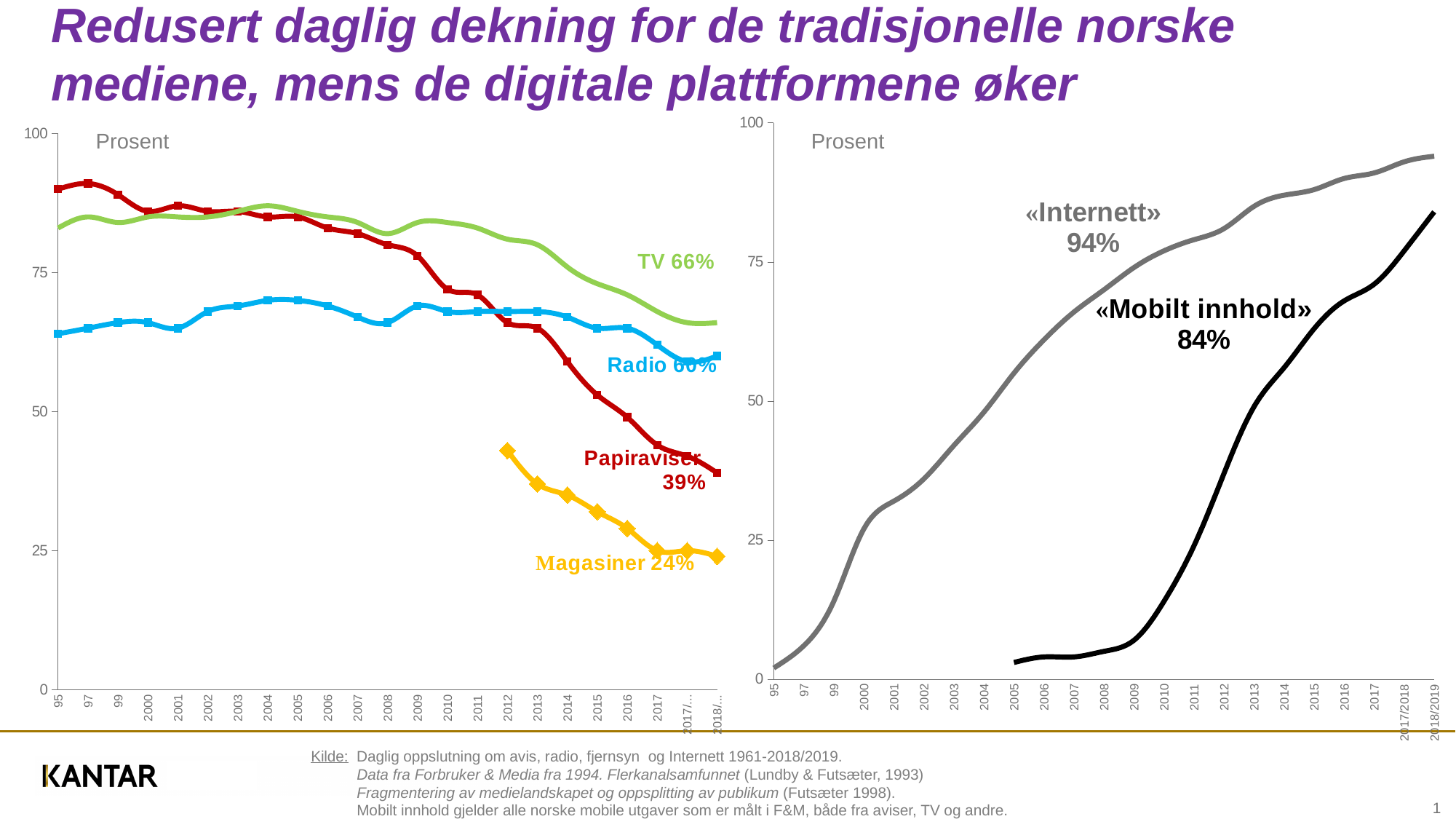
In the right chart, what is the value labelled for «Internett»? 94% In the left chart, does the Papiraviser line rise or fall from 2010 to the end of the series? fall In the left chart, what is the latest value labelled for TV? 66% In the right chart, which series has the higher labelled value, «Internett» or «Mobilt innhold»? «Internett» How many labelled series are plotted in the left chart? 4 What kind of chart is shown on the left side of the slide? line chart In the left chart, what is the difference between the labelled values for TV and Magasiner? 42 percentage points In the right chart, what is the value labelled for «Mobilt innhold»? 84% In the right chart, is the value for «Mobilt innhold» in 2010 greater or less than 25? less In the left chart, what is the latest value labelled for Papiraviser? 39% In the left chart, what is the latest value labelled for Magasiner? 24% In the right chart, what is the difference between the labelled values for «Internett» and «Mobilt innhold»? 10 percentage points